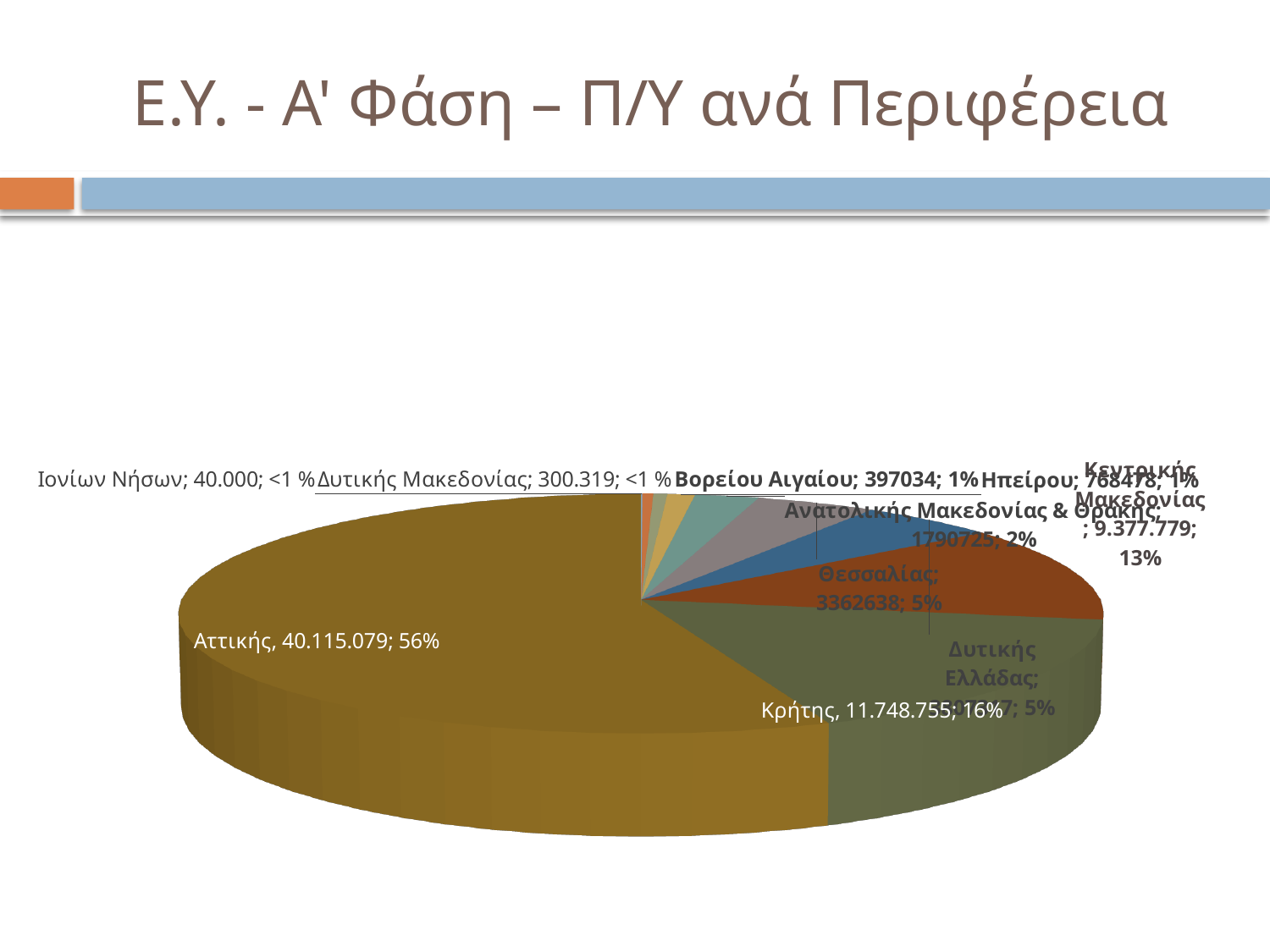
What share of the pie does Αττικής represent? 56% Which is larger, the value for Κεντρικής Μακεδονίας or the value for Κρήτης? Κρήτης What is the value shown for Θεσσαλίας? 3362638 What is the value shown for Ιονίων Νήσων? 40.000 What is the title of the chart slide? Ε.Υ. - Α' Φάση – Π/Υ ανά Περιφέρεια What is the value shown for Αττικής? 40.115.079 What is the value shown for Κεντρικής Μακεδονίας? 9.377.779 Which region has the smallest value in the pie? Ιονίων Νήσων What type of chart is shown on the slide? pie chart Which region has the largest slice of the pie? Αττικής What share of the pie does Κρήτης represent? 16% What is the value shown for Κρήτης? 11.748.755